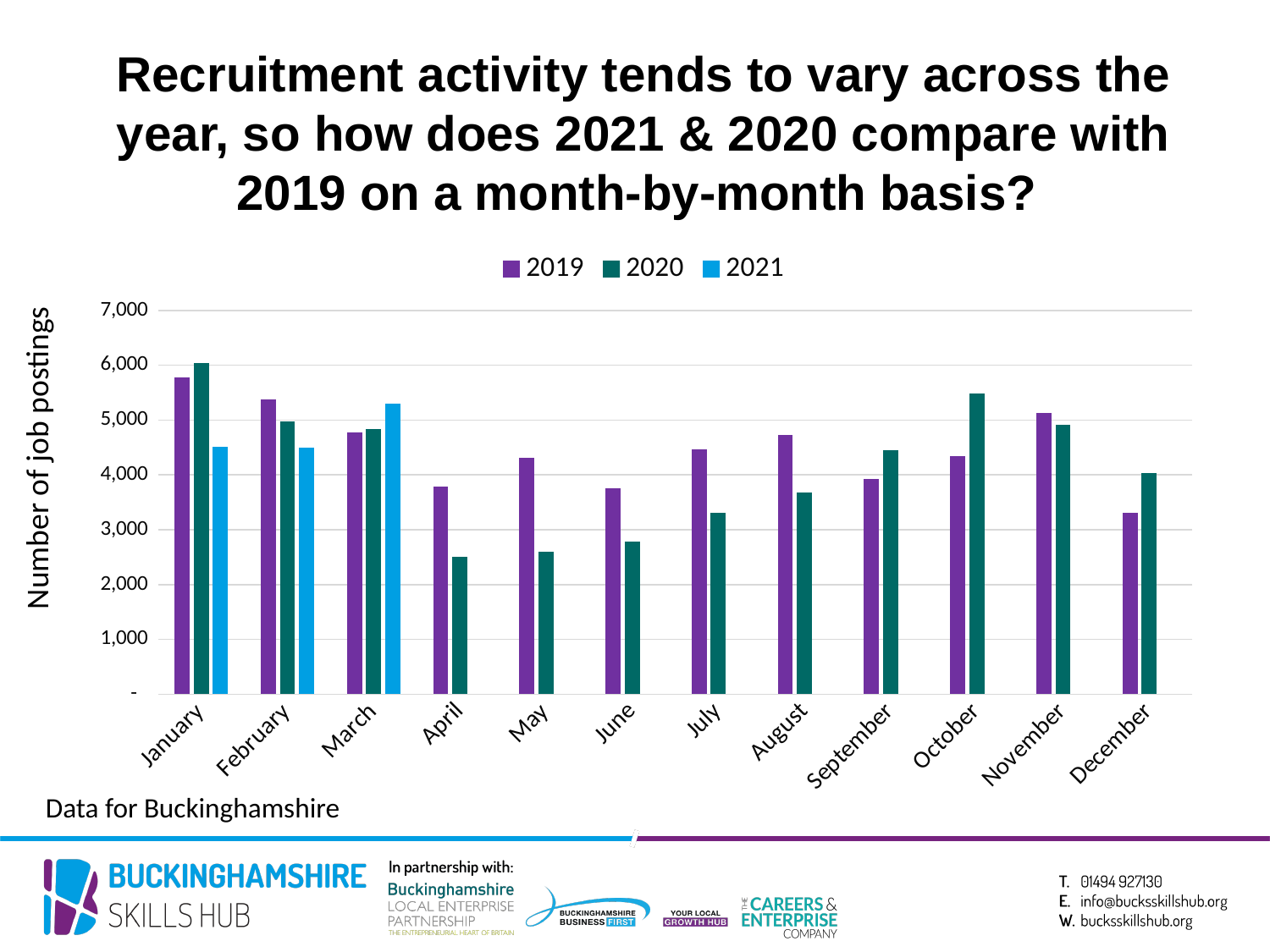
In April, which year has the larger number of job postings, 2019 or 2020? 2019 How many months are shown along the x axis? 12 In which month is the 2020 value lowest? April Is the value for October 2020 greater or less than 5,000? greater In which month is the 2020 value highest? January Is the value for May 2020 greater or less than 3,000? less Do the 2020 values rise or fall from April to October? rise How many series does the legend list? 3 In October, which year has the larger number of job postings, 2019 or 2020? 2020 What kind of chart is shown on the slide? Bar chart In which month is the 2019 value highest? January In March, which year has the larger number of job postings, 2019 or 2021? 2021